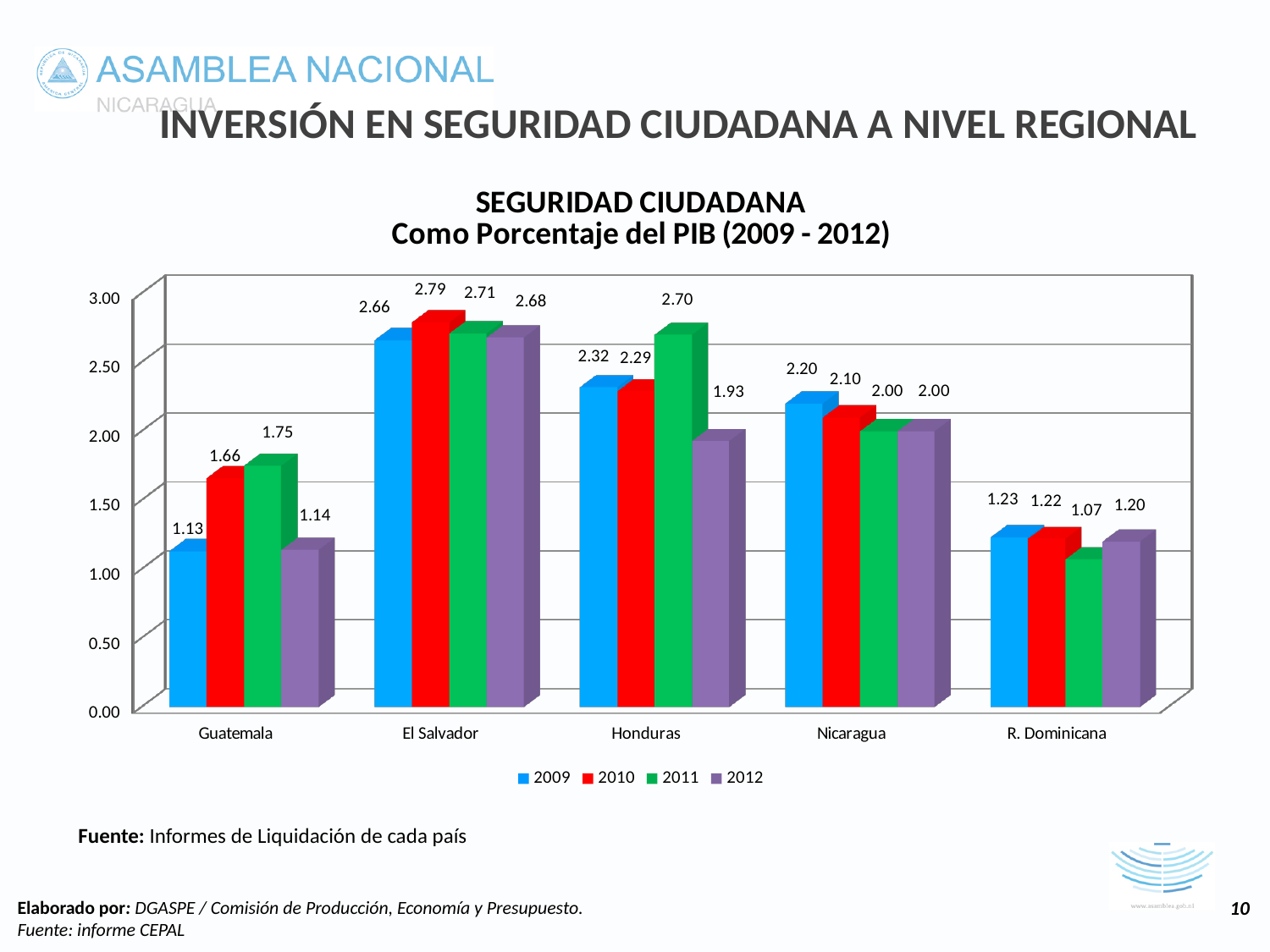
How many countries are shown on the x axis? 5 What is the value for Guatemala in 2009? 1.13 What is the value for Honduras in 2012? 1.93 What is the difference between the 2011 and 2012 values for Honduras? 0.77 How many series does the legend list? 4 What is the value for El Salvador in 2010? 2.79 Which country has the highest value in 2011? El Salvador Which is larger for Nicaragua: the 2009 value or the 2010 value? 2009 Is the value for R. Dominicana in 2011 greater or less than 1.50? less What kind of chart is shown? bar chart Which country has the lowest value in 2012? Guatemala Do the values for Nicaragua rise or fall from 2009 to 2012? fall